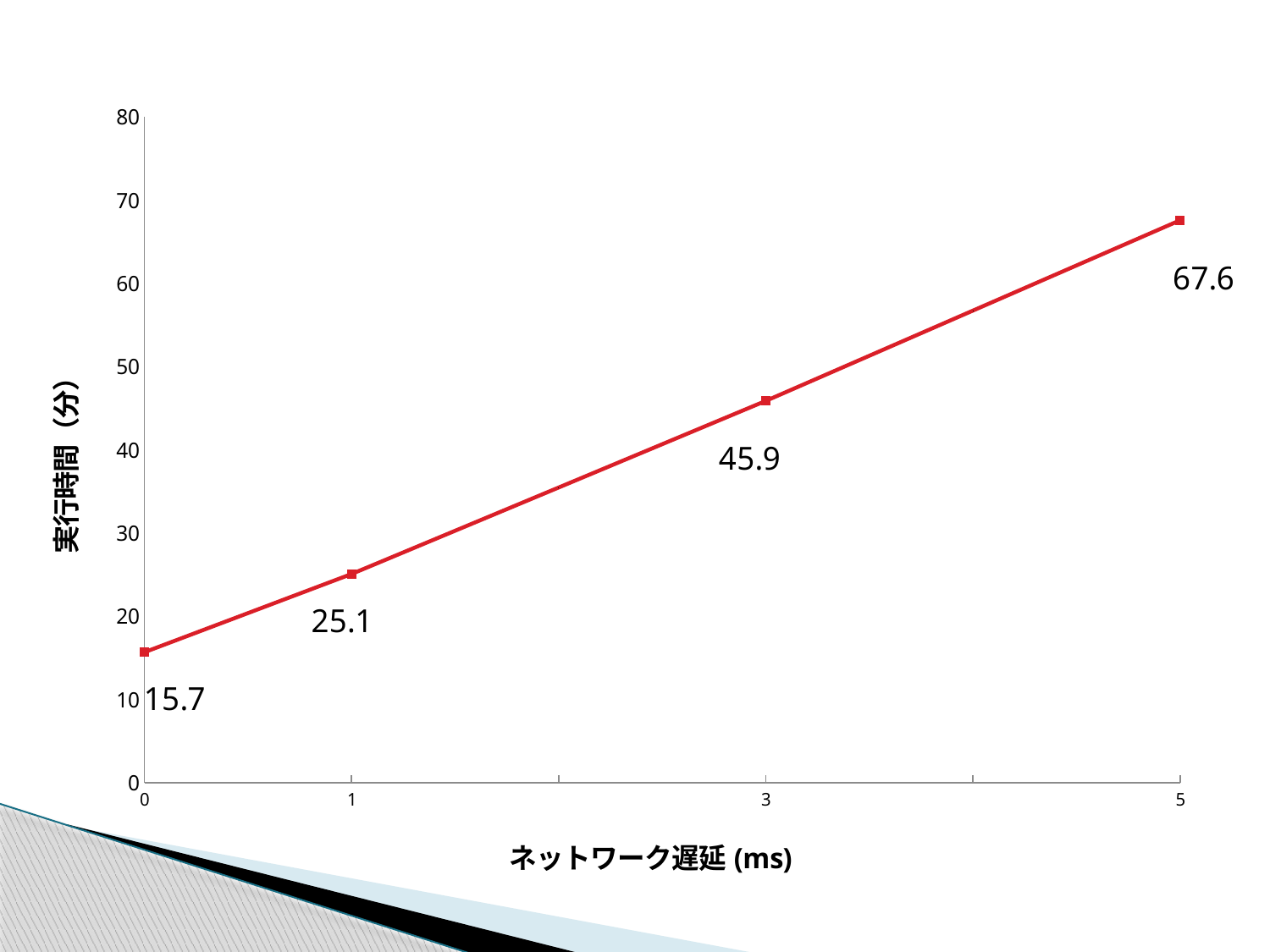
What is the execution time (実行時間) at a network delay of 0 ms? 15.7 What is the difference in execution time between 5 ms and 0 ms network delay? 51.9 Does the execution time rise or fall as network delay increases? Rises What is the difference in execution time between 3 ms and 1 ms network delay? 20.8 Which has a larger execution time: 1 ms or 3 ms network delay? 3 ms At which network delay is the execution time lowest? 0 ms What is the execution time at a network delay of 1 ms? 25.1 At which network delay is the execution time highest? 5 ms What is the execution time at a network delay of 5 ms? 67.6 What kind of chart is shown on the slide? Line chart What is the execution time at a network delay of 3 ms? 45.9